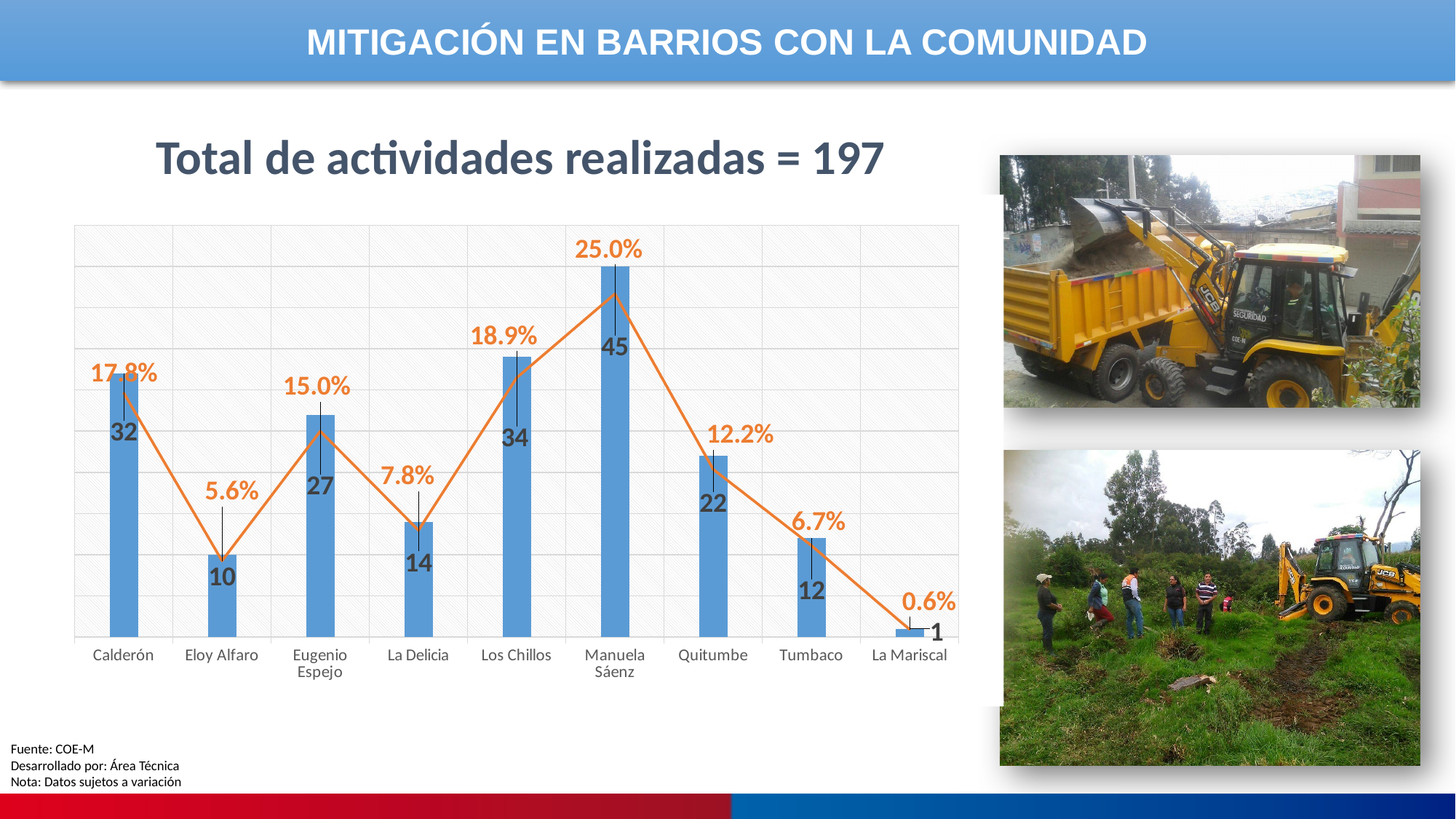
How many activities were carried out in Manuela Sáenz? 45 What percentage share is shown for Los Chillos? 18.9% What kind of chart is this? Bar chart with a line overlay Do the values rise or fall from Quitumbe to La Mariscal? Fall What percentage is shown for La Mariscal? 0.6% How many categories are shown on the x axis? 9 How many activities were carried out in Eugenio Espejo? 27 What is the difference in activities between Manuela Sáenz and Calderón? 13 Which category has the lowest number of activities? La Mariscal Which category has the highest number of activities? Manuela Sáenz Which has more activities, Quitumbe or Tumbaco? Quitumbe What total number of activities is stated above the chart? 197